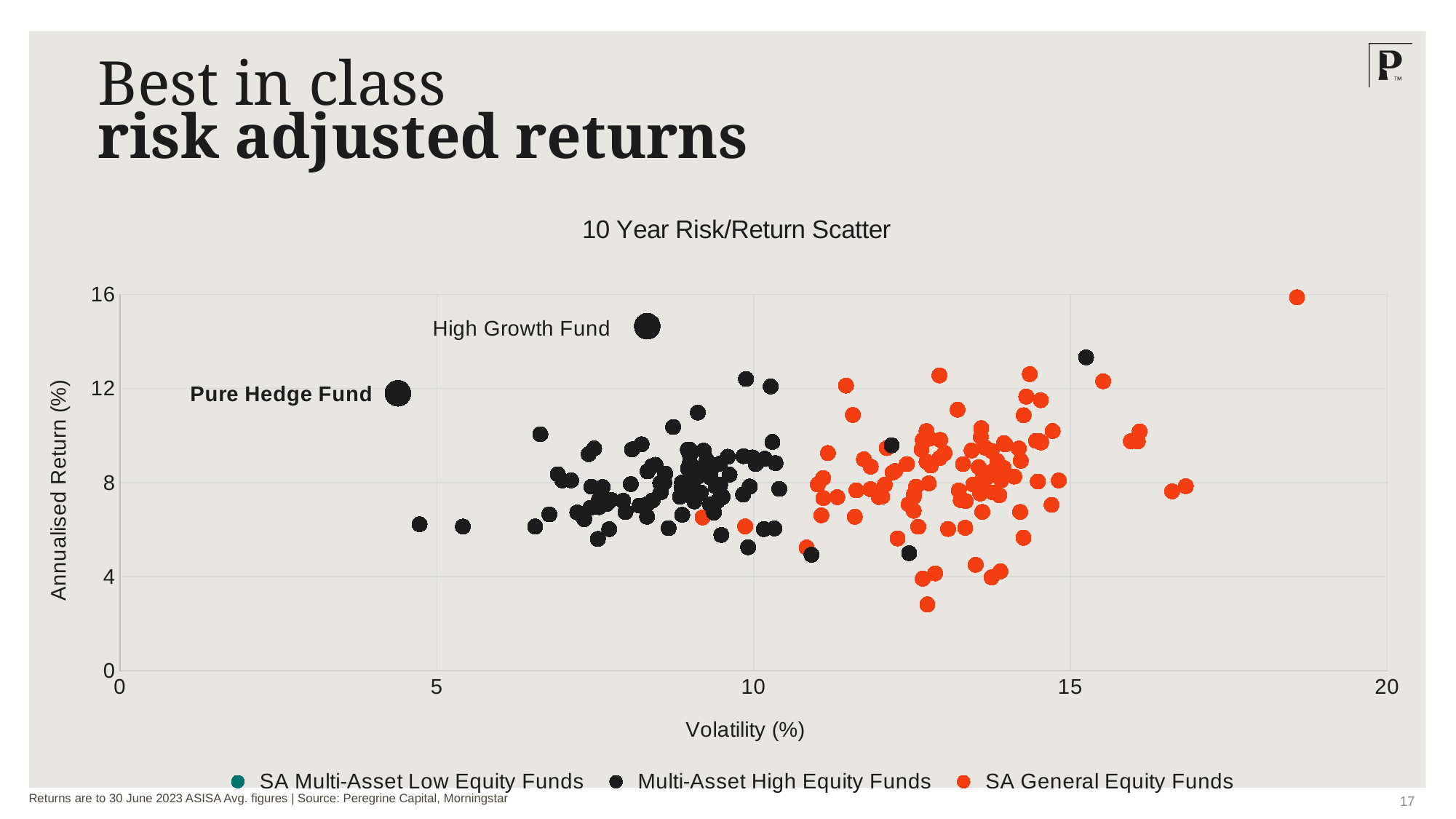
Is the volatility for the High Growth Fund greater or less than 10? less Is the annualised return for the Pure Hedge Fund greater or less than 16? less Is the volatility for the Pure Hedge Fund greater or less than 5? less Which of the two labelled funds, High Growth Fund or Pure Hedge Fund, has the higher annualised return? High Growth Fund How many series does the legend list? 3 What is the label of the vertical axis? Annualised Return (%) Which of the two labelled funds, High Growth Fund or Pure Hedge Fund, has the lower volatility? Pure Hedge Fund What is the title of the chart? 10 Year Risk/Return Scatter What kind of chart is shown on the slide? Scatter chart